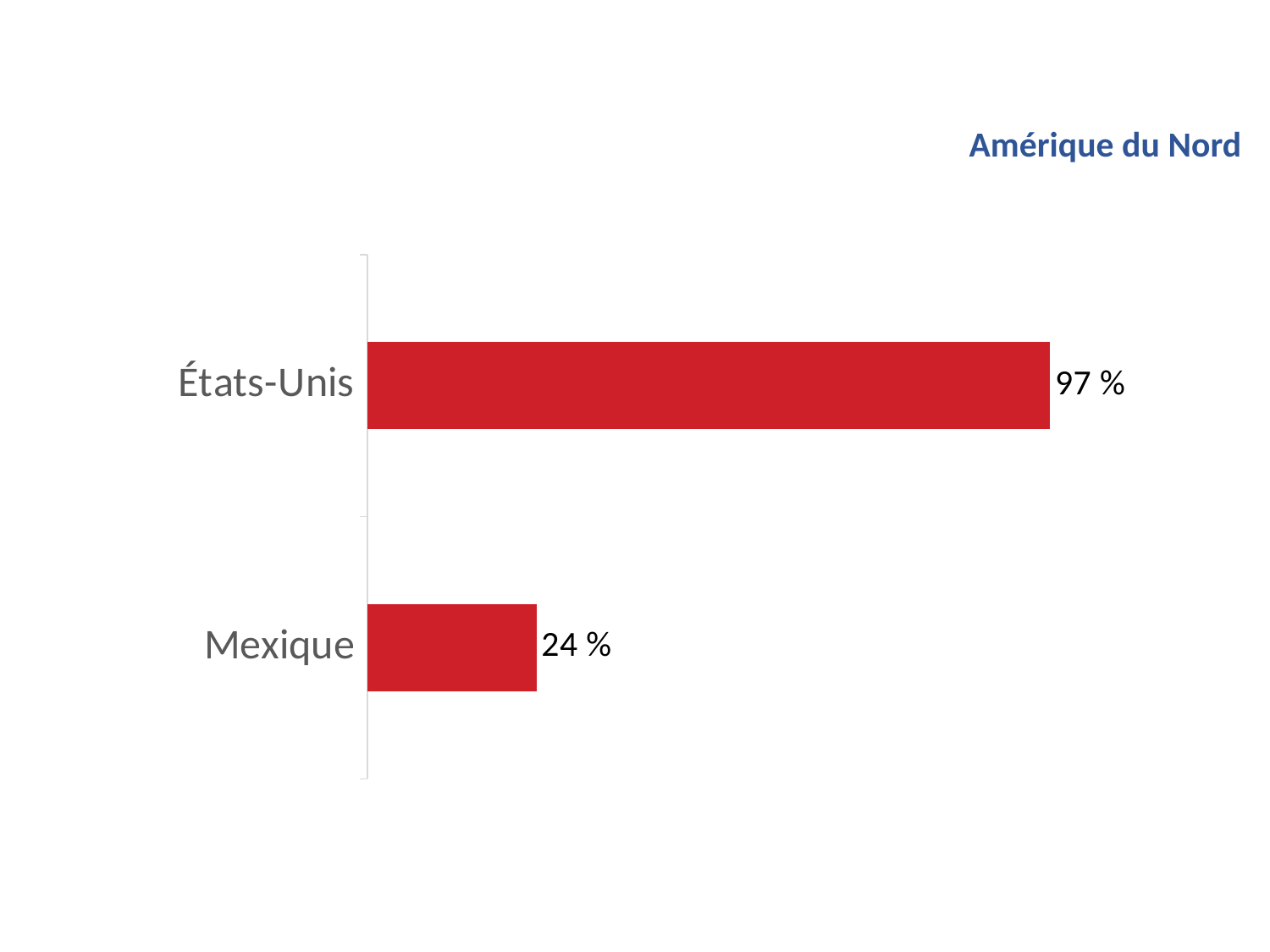
What is the value for États-Unis? 97 % How many categories are shown in the chart? 2 What is the difference between the values for États-Unis and Mexique? 73 % What is the value for Mexique? 24 % What is the title shown above the chart? Amérique du Nord Which category has the highest value? États-Unis What kind of chart is shown on the slide? Bar chart Which category has the lowest value? Mexique Which is larger, the value for États-Unis or the value for Mexique? États-Unis What colour are the bars in the chart? Red